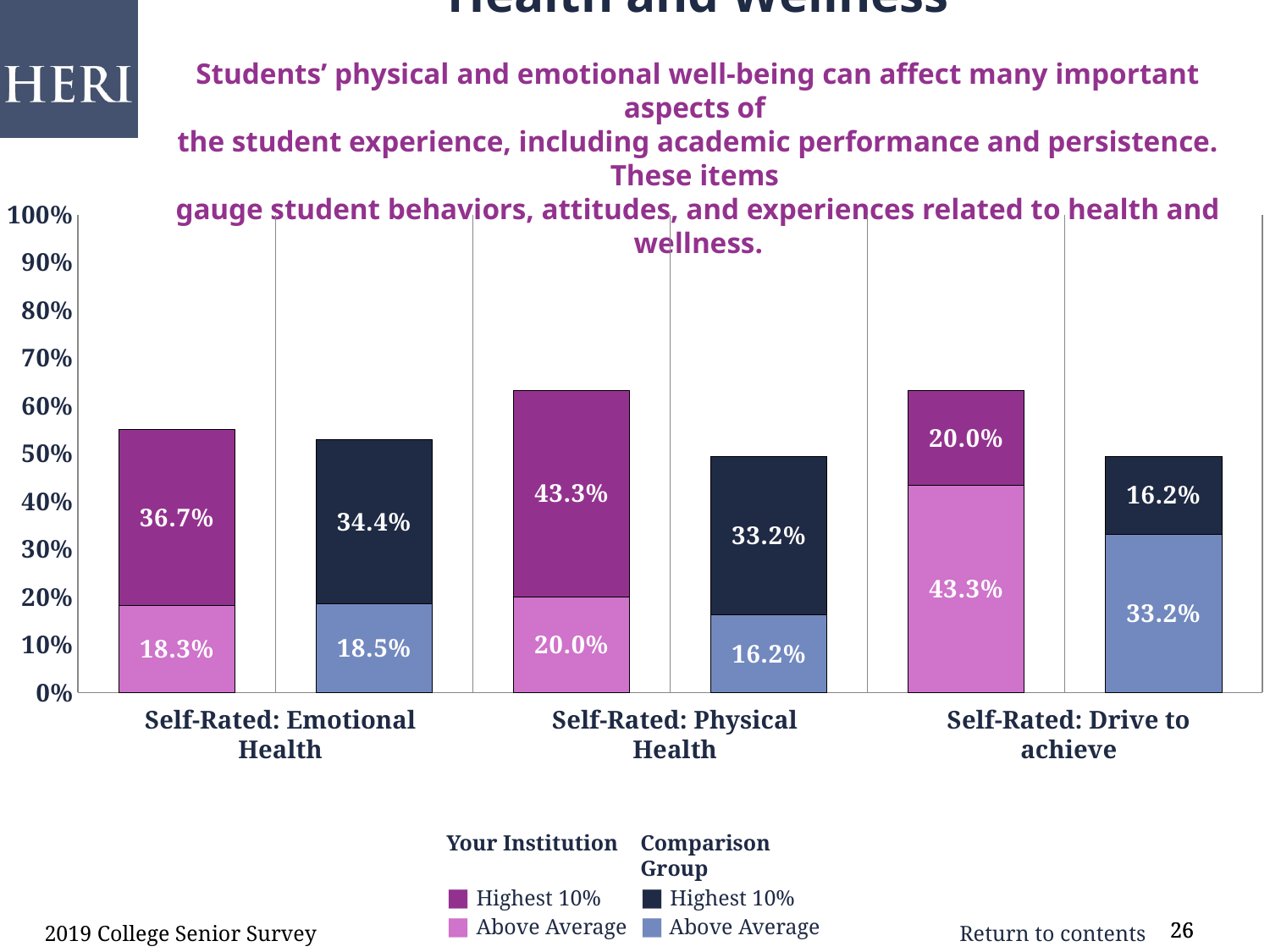
What is the Highest 10% value for Your Institution in the Self-Rated: Emotional Health category? 36.7% What is the Above Average value for Your Institution in the Self-Rated: Drive to achieve category? 43.3% How many entries does the chart legend list? 4 What is the total of the Your Institution stacked bar for Self-Rated: Emotional Health? 55.0% What kind of chart is shown on the slide? Stacked bar chart In the Self-Rated: Drive to achieve category, which is larger: the Above Average value for Your Institution or for the Comparison Group? Your Institution What is the difference between the Highest 10% values for Your Institution and the Comparison Group in the Self-Rated: Physical Health category? 10.1% What is the Highest 10% value for the Comparison Group in the Self-Rated: Emotional Health category? 34.4% Is the total of the Your Institution stacked bar for Self-Rated: Physical Health greater or less than 60%? greater How many categories are shown on the x axis of the chart? 3 What is the Above Average value for the Comparison Group in the Self-Rated: Physical Health category? 16.2% What is the total of the Comparison Group stacked bar for Self-Rated: Physical Health? 49.4%